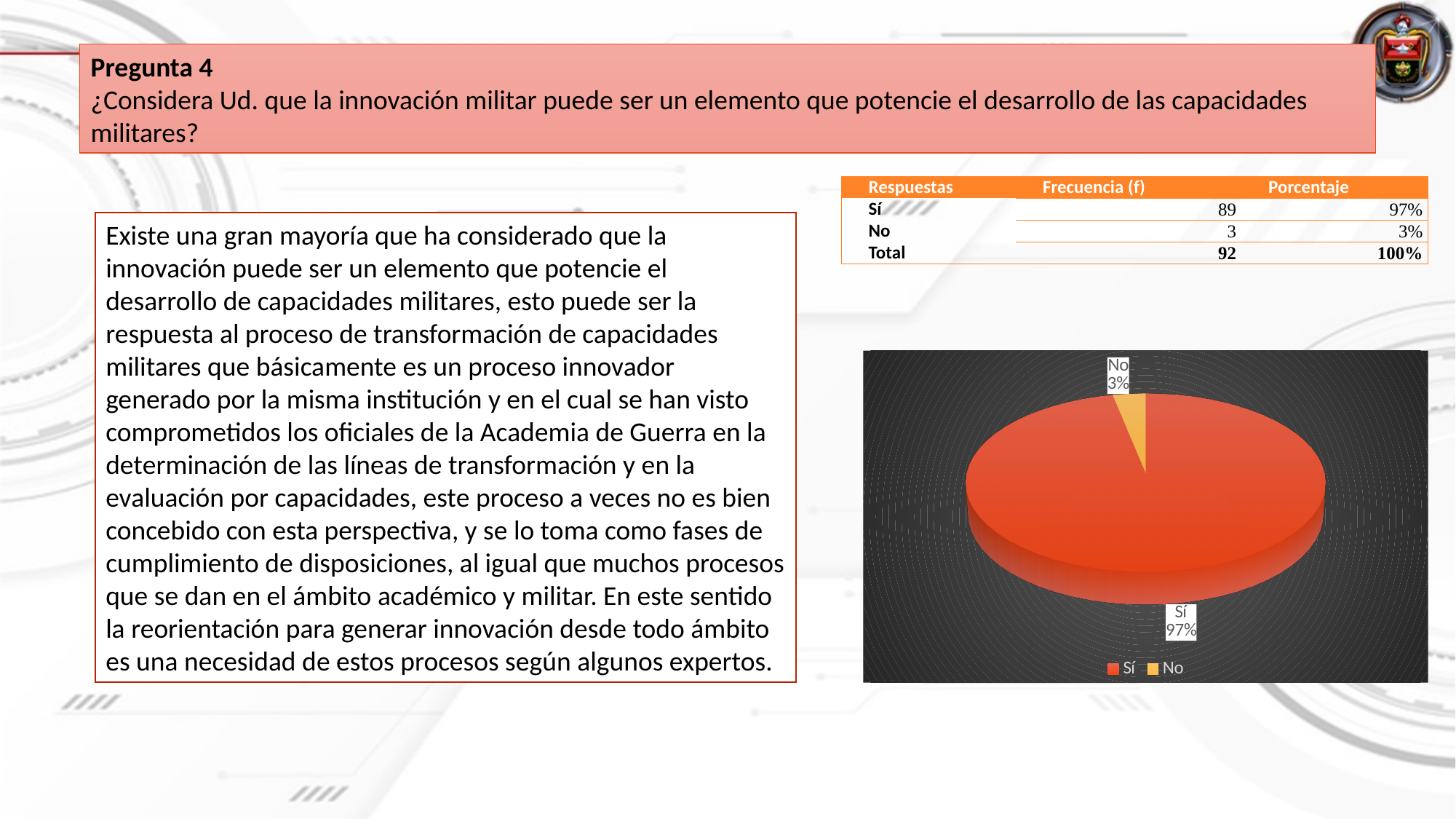
How many slices does the pie chart have? 2 Which is larger in the pie chart, the 'Sí' slice or the 'No' slice? Sí What kind of chart is shown on the slide? pie chart What is the difference in percentage points between the 'Sí' and 'No' slices of the pie chart? 94 Which slice of the pie chart is the largest? Sí How many entries does the pie chart's legend list? 2 What percentage does the 'Sí' slice of the pie chart show? 97% What colour is the 'Sí' slice in the pie chart? red What colour is the 'No' slice in the pie chart? orange Which slice of the pie chart is the smallest? No What percentage does the 'No' slice of the pie chart show? 3%